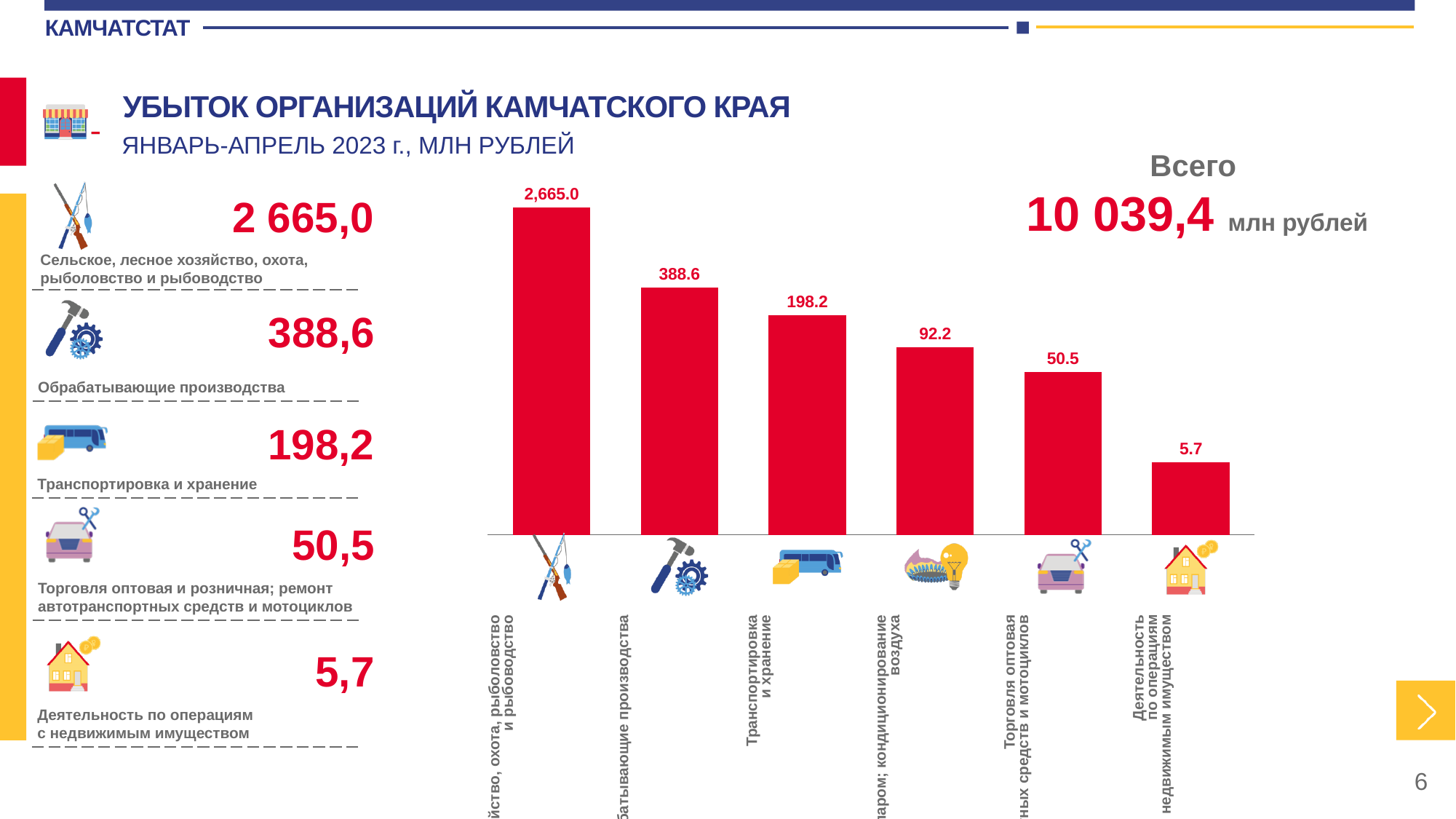
How many bars does the chart contain? 6 What total value (Всего) is printed next to the chart? 10 039,4 млн рублей What is the value of the bar for Обрабатывающие производства? 388.6 What is the difference between the bars for Обрабатывающие производства and Транспортировка и хранение? 190.4 What is the value of the bar for Деятельность по операциям с недвижимым имуществом? 5.7 Which is larger: the bar for Транспортировка и хранение or the bar for Торговля оптовая и розничная; ремонт автотранспортных средств и мотоциклов? Транспортировка и хранение Which category has the lowest bar in the chart? Деятельность по операциям с недвижимым имуществом What is the value of the bar for Торговля оптовая и розничная; ремонт автотранспортных средств и мотоциклов? 50.5 Do the bar values rise or fall from left to right along the x axis? fall What kind of chart is shown on the slide? bar chart Which category has the highest bar in the chart? Сельское, лесное хозяйство, охота, рыболовство и рыбоводство What is the value of the bar for Транспортировка и хранение? 198.2